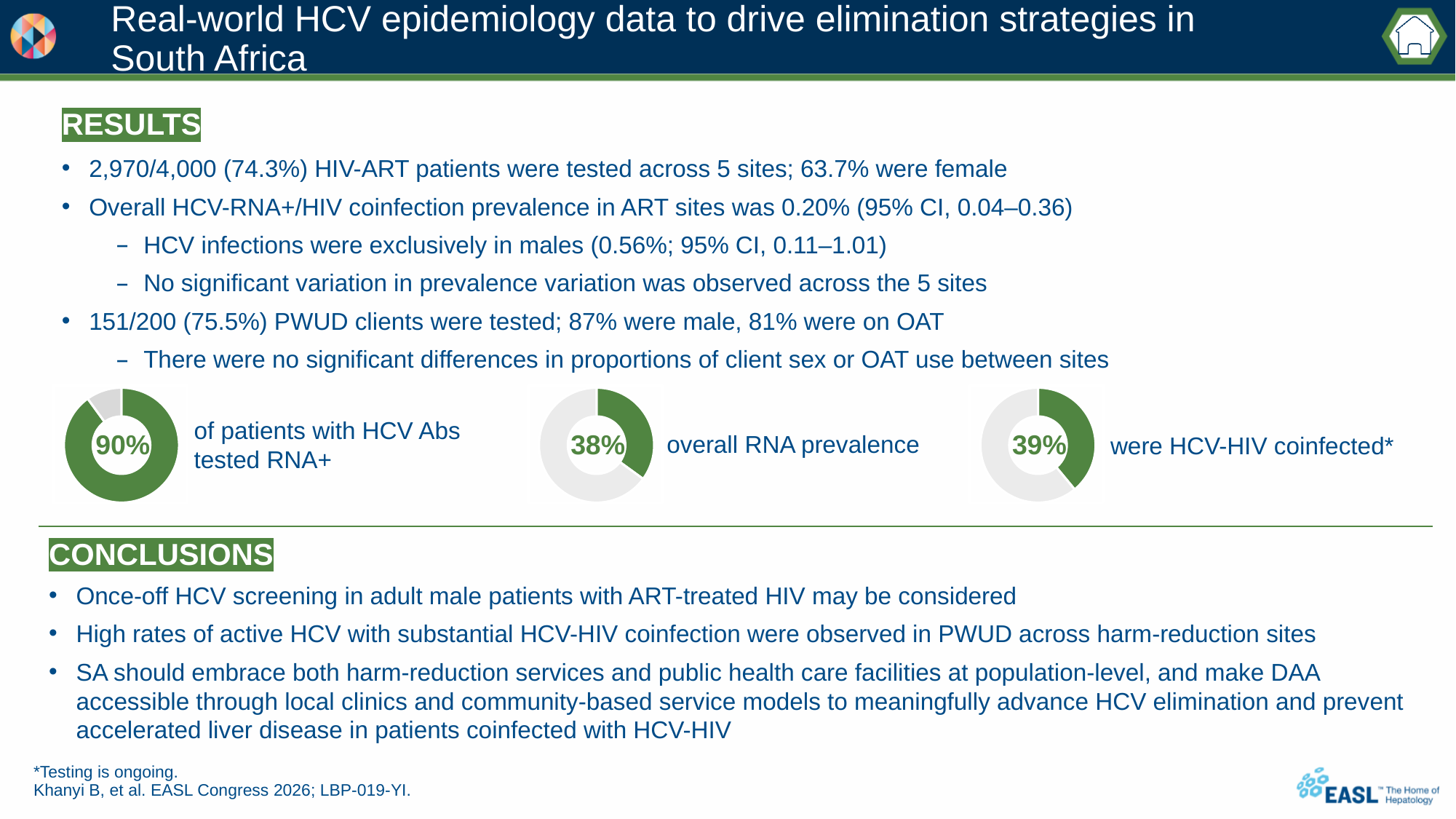
What is the difference between the right donut chart value (39%) and the middle donut chart value (38%)? 1 percentage point Which is larger: the overall RNA prevalence in the middle donut chart or the HCV-HIV coinfected percentage in the right donut chart? The HCV-HIV coinfected percentage (39%) In the left donut chart, what percentage of patients with HCV Abs tested RNA+? 90% How many donut charts are shown on the slide? 3 Which of the three donut charts shows the highest percentage? The left chart (90%, patients with HCV Abs tested RNA+) In the right donut chart, what percentage were HCV-HIV coinfected? 39% What is the difference between the percentage in the left donut chart (90%) and the percentage in the middle donut chart (38%)? 52 percentage points In the left donut chart, what share of the ring is filled by the green segment? 90% What kind of chart is used to display the 90%, 38% and 39% figures on the slide? Donut (pie) chart What colour is used for the filled (value) segment in each of the three donut charts? Green Which of the three donut charts shows the lowest percentage? The middle chart (38%, overall RNA prevalence) In the middle donut chart, what is the overall RNA prevalence shown? 38%